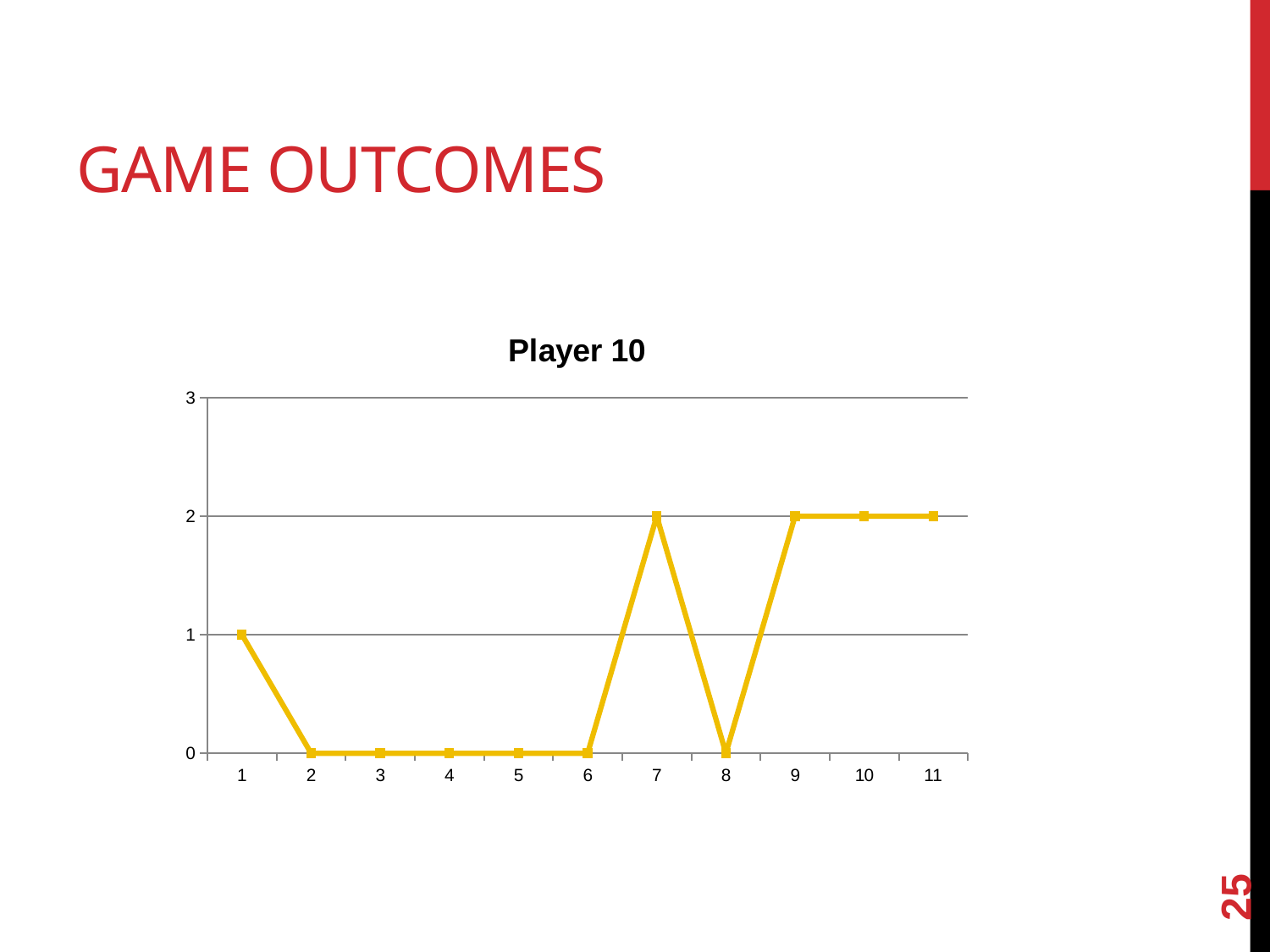
What kind of chart is shown on the slide? line chart What is the value at game 8? 0 How many data points are plotted on the chart? 11 What is the value at game 11? 2 What is the value at game 1? 1 Which is larger, the value at game 1 or the value at game 9? game 9 What is the difference between the values at game 7 and game 8? 2 What is the title of the chart? Player 10 What colour is the plotted line? yellow What is the highest value reached on the chart? 2 What is the value at game 7? 2 Do the values rise or fall from game 1 to game 2? fall